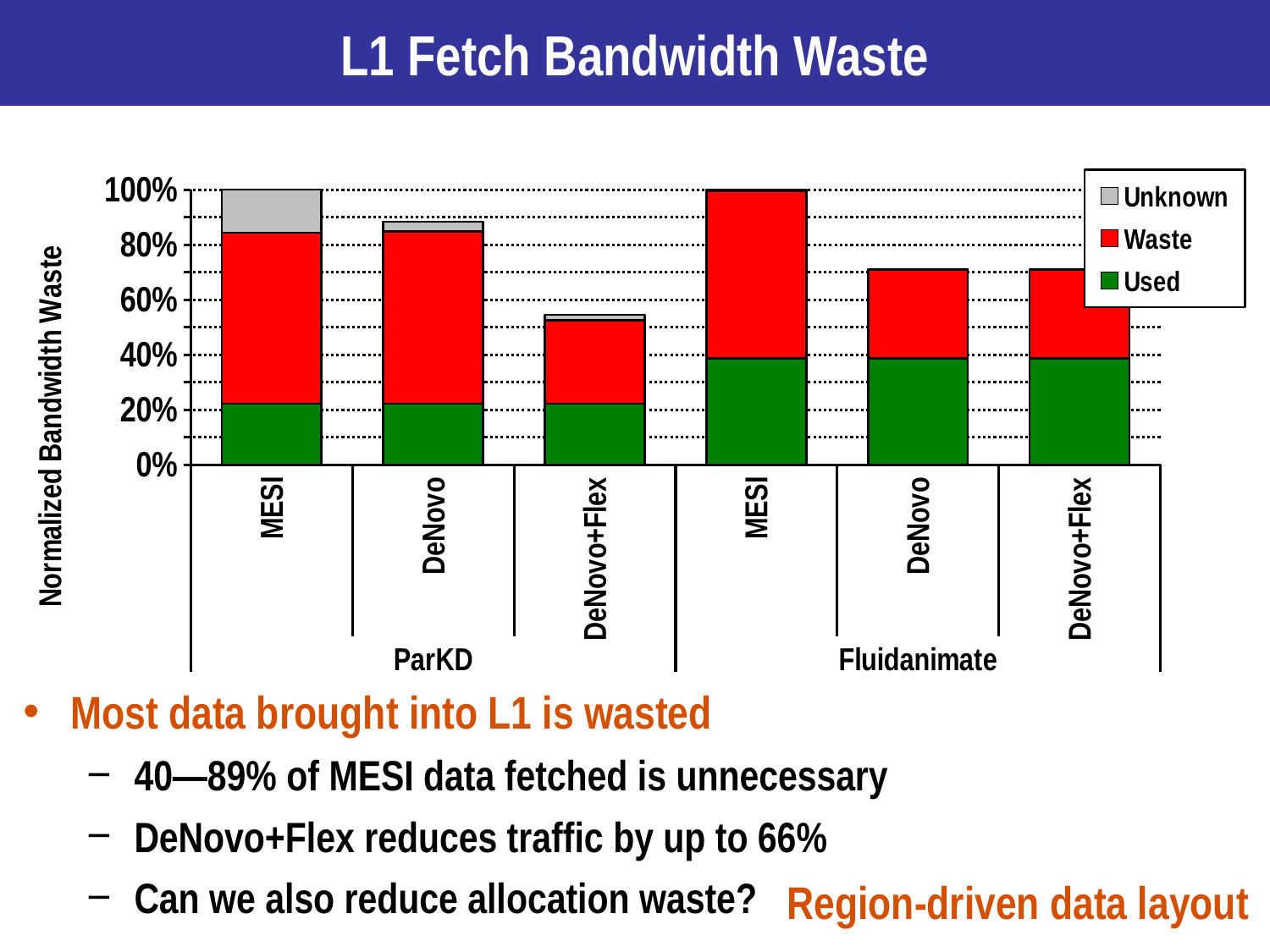
What is the title of the y axis? Normalized Bandwidth Waste Is the total height of the DeNovo+Flex bar for ParKD greater or less than 60%? less Is the Used portion of the MESI bar for ParKD greater or less than 40%? less What kind of chart is shown on the slide? Stacked bar chart Which MESI bar has the larger Used portion: ParKD or Fluidanimate? Fluidanimate How many series does the legend list? 3 How many bars are plotted in the chart? 6 What are the three entries in the legend? Unknown, Waste, Used Which bar has the lowest total height in the whole chart? DeNovo+Flex (ParKD) Which configuration has the tallest bar in the ParKD group? MESI In the ParKD group, which bar is taller in total: DeNovo or DeNovo+Flex? DeNovo Is the total height of the DeNovo bar for Fluidanimate greater or less than 60%? greater